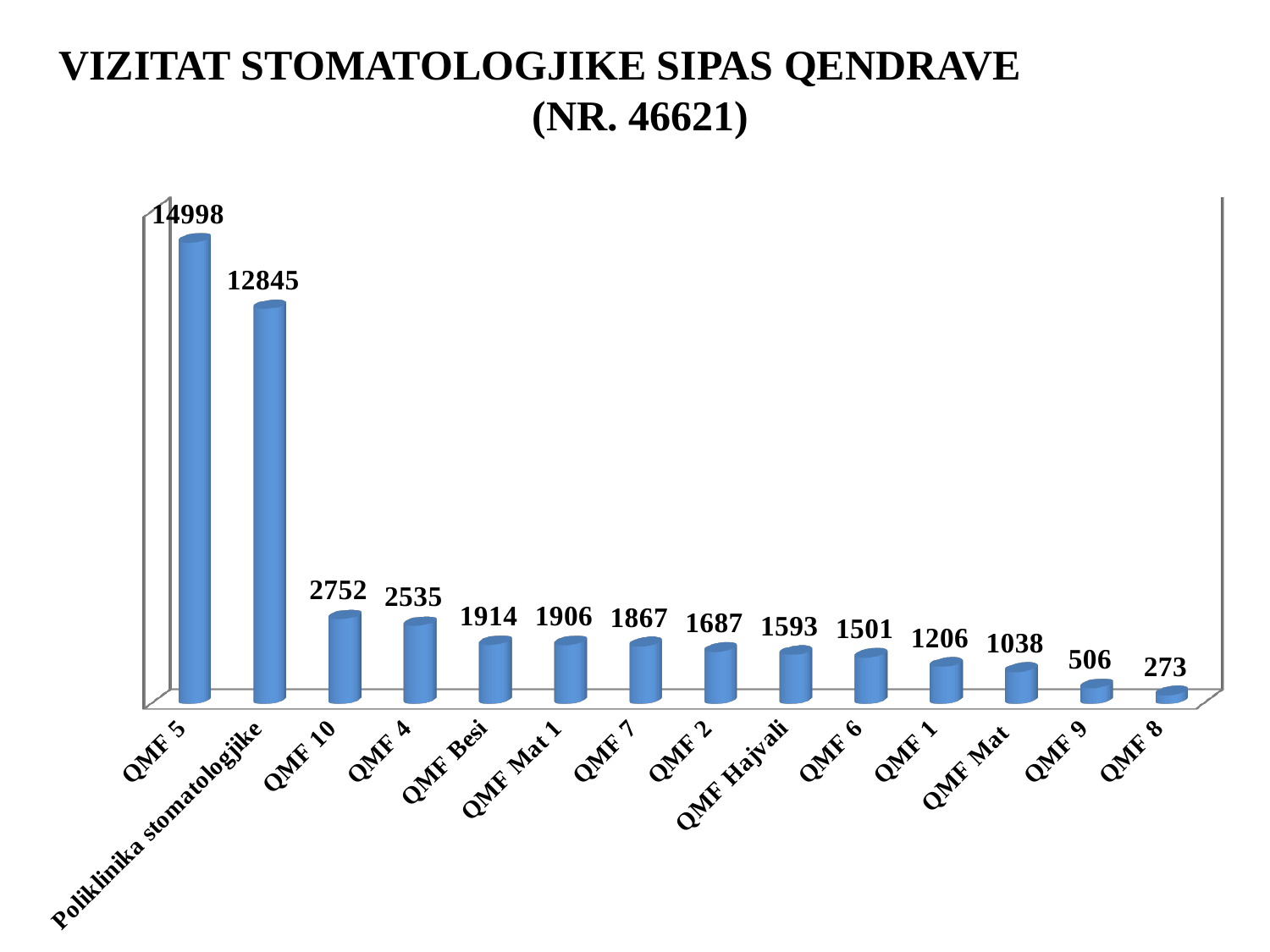
What is the value for QMF Hajvali? 1593 Which category has the highest value? QMF 5 What is the difference between the values for QMF 10 and QMF 4? 217 What is the value for QMF 9? 506 Which is larger, the value for QMF 1 or the value for QMF Mat? QMF 1 How many categories are shown in the chart? 14 Which category has the lowest value? QMF 8 What is the title of the chart? VIZITAT STOMATOLOGJIKE SIPAS QENDRAVE (NR. 46621) What is the value for Poliklinika stomatologjike? 12845 What kind of chart is this? bar chart What is the value for QMF 5? 14998 What is the difference between the values for QMF 5 and Poliklinika stomatologjike? 2153